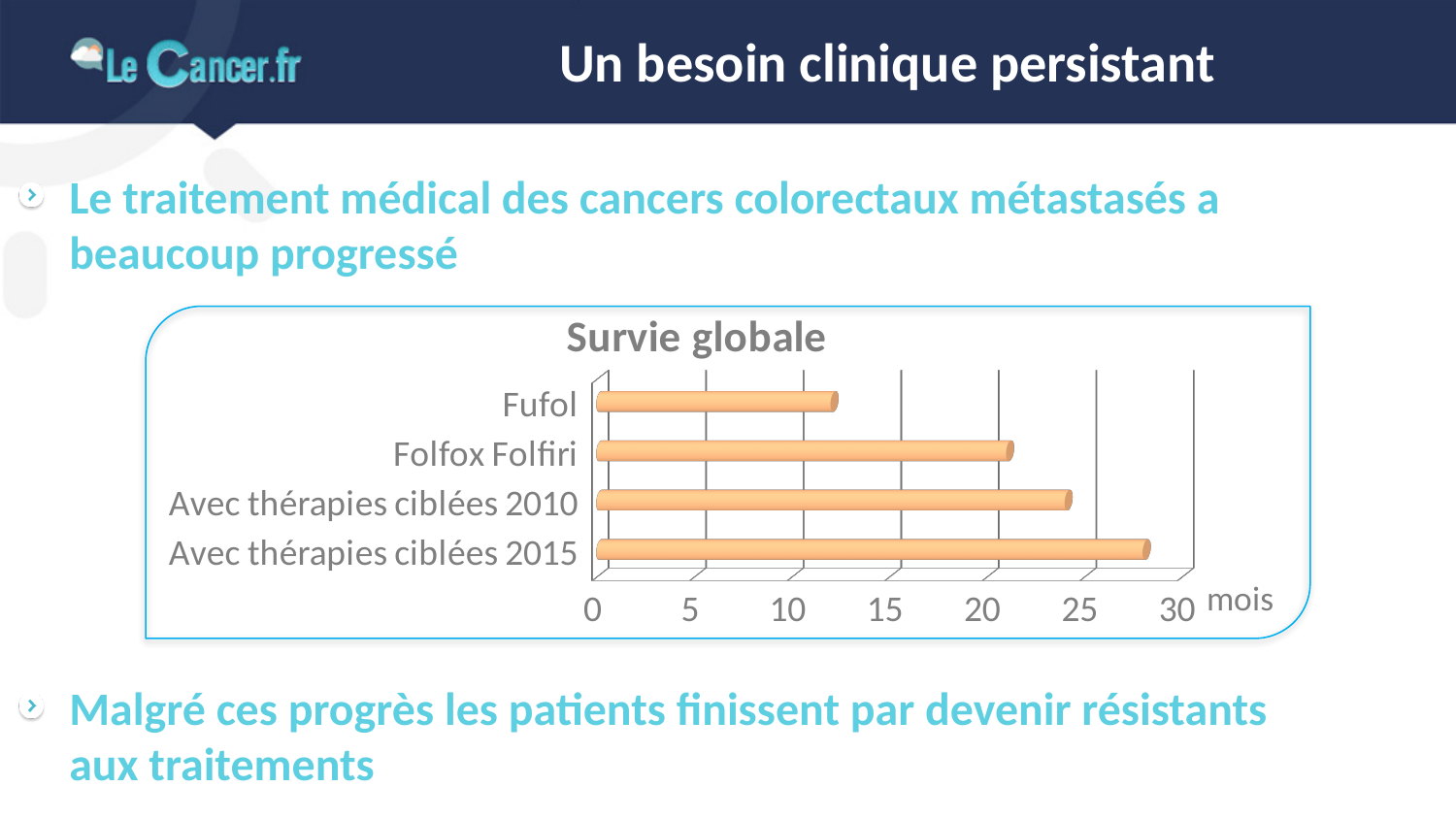
What is the title of the chart on the slide? Survie globale Which category has the lowest value in the "Survie globale" chart? Fufol How many categories are plotted in the "Survie globale" chart? 4 Is the value for Avec thérapies ciblées 2015 greater or less than 25? greater Is the value for Fufol greater or less than 15? less Which category has the highest value in the "Survie globale" chart? Avec thérapies ciblées 2015 What kind of chart is shown under the title "Survie globale"? bar chart Is the value for Avec thérapies ciblées 2010 greater or less than 25? less Do the bar values increase or decrease going from the top category (Fufol) to the bottom category (Avec thérapies ciblées 2015)? increase Which is larger, the value for Folfox Folfiri or the value for Avec thérapies ciblées 2010? Avec thérapies ciblées 2010 What unit is shown at the end of the horizontal axis of the chart? mois